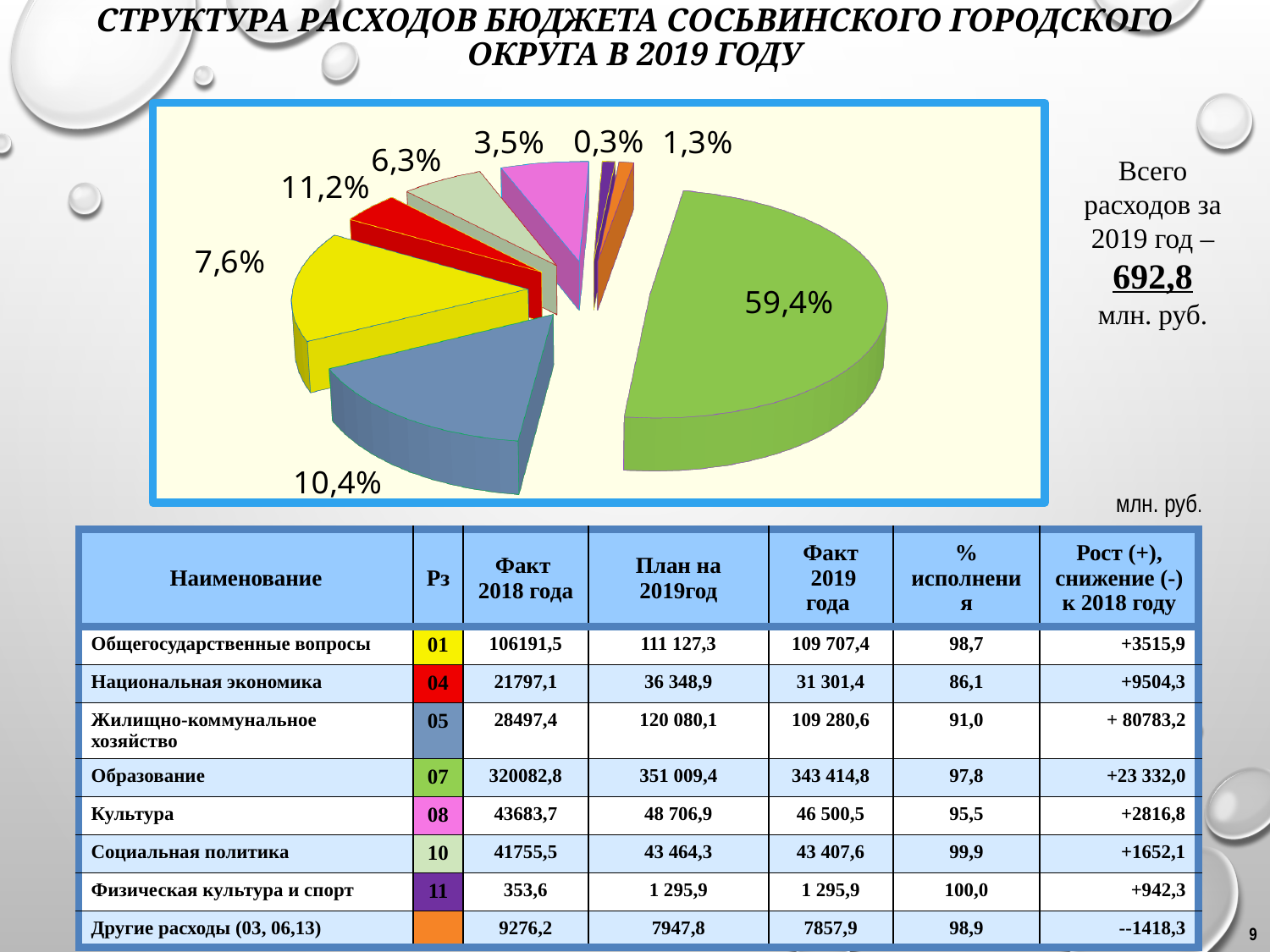
What is the second largest share shown in the pie chart? 11,2% What colour is the largest slice of the pie chart? green How many slices does the pie chart have? 8 What is the share of the smallest slice in the pie chart? 0,3% What is the difference between the largest slice (59,4%) and the second largest slice (11,2%) in the pie chart? 48,2% Which is larger in the pie chart: the slice labelled 10,4% or the slice labelled 7,6%? 10,4% According to the text next to the pie chart, what was the total expenditure for 2019? 692,8 млн. руб. Is the largest slice of the pie chart greater or less than 50%? greater What kind of chart is shown on the slide? pie chart What is the share of the largest slice in the pie chart? 59,4% What is the share of the yellow slice in the pie chart? 7,6% What is the share of the blue-grey slice at the bottom of the pie chart? 10,4%